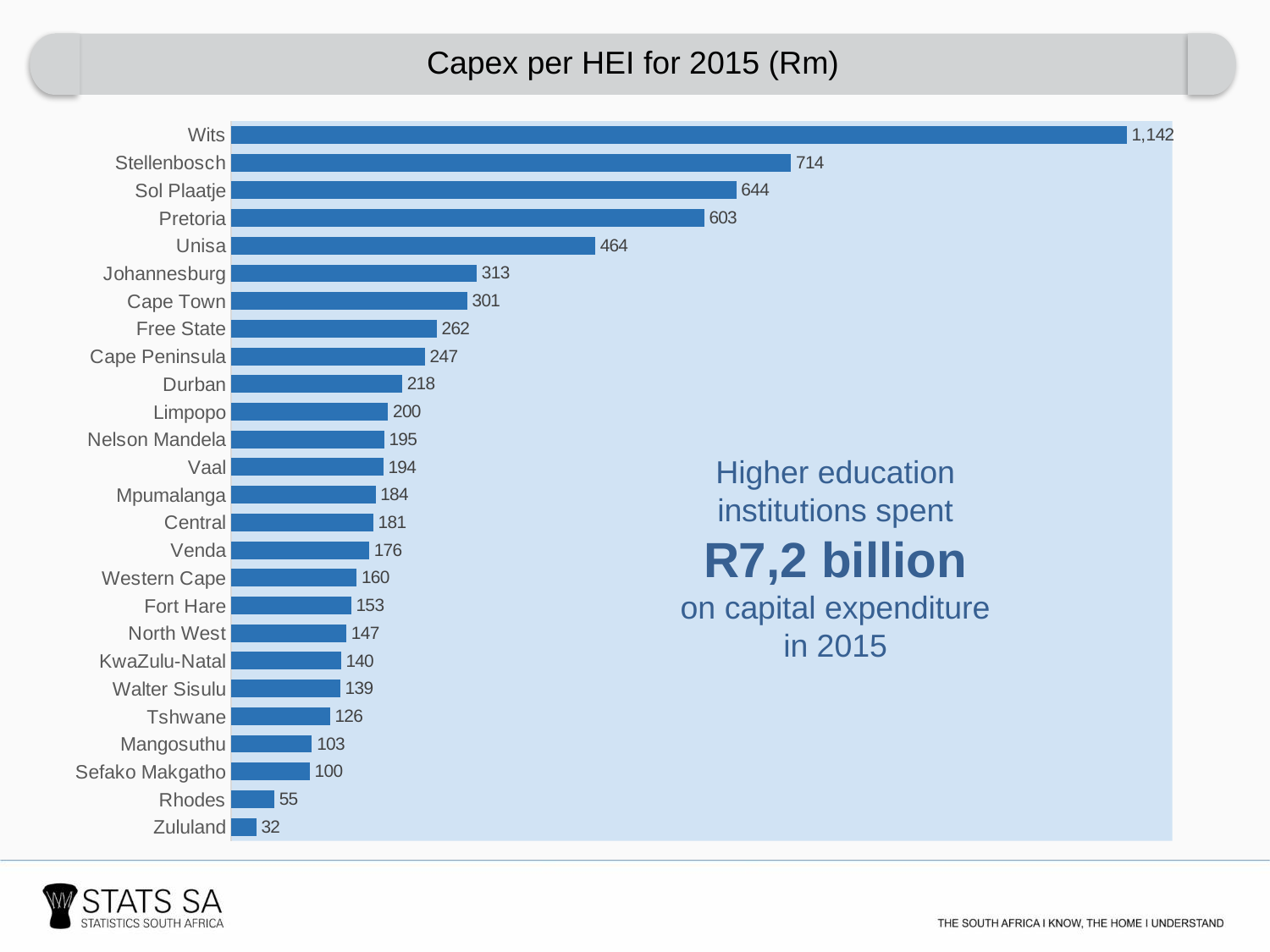
How many institutions are shown in the chart? 26 Which has a larger capex, Rhodes or Mangosuthu? Mangosuthu Which institution has the lowest capex? Zululand What is the capex value for Walter Sisulu? 139 What is the title of the chart? Capex per HEI for 2015 (Rm) What kind of chart is shown on the slide? Bar chart Which institution has the highest capex? Wits What is the difference between the capex of Stellenbosch and Sol Plaatje? 70 What is the difference between the capex of Wits and Pretoria? 539 What is the capex value for Wits? 1,142 What is the capex value for Unisa? 464 Which has a larger capex, Johannesburg or Cape Town? Johannesburg